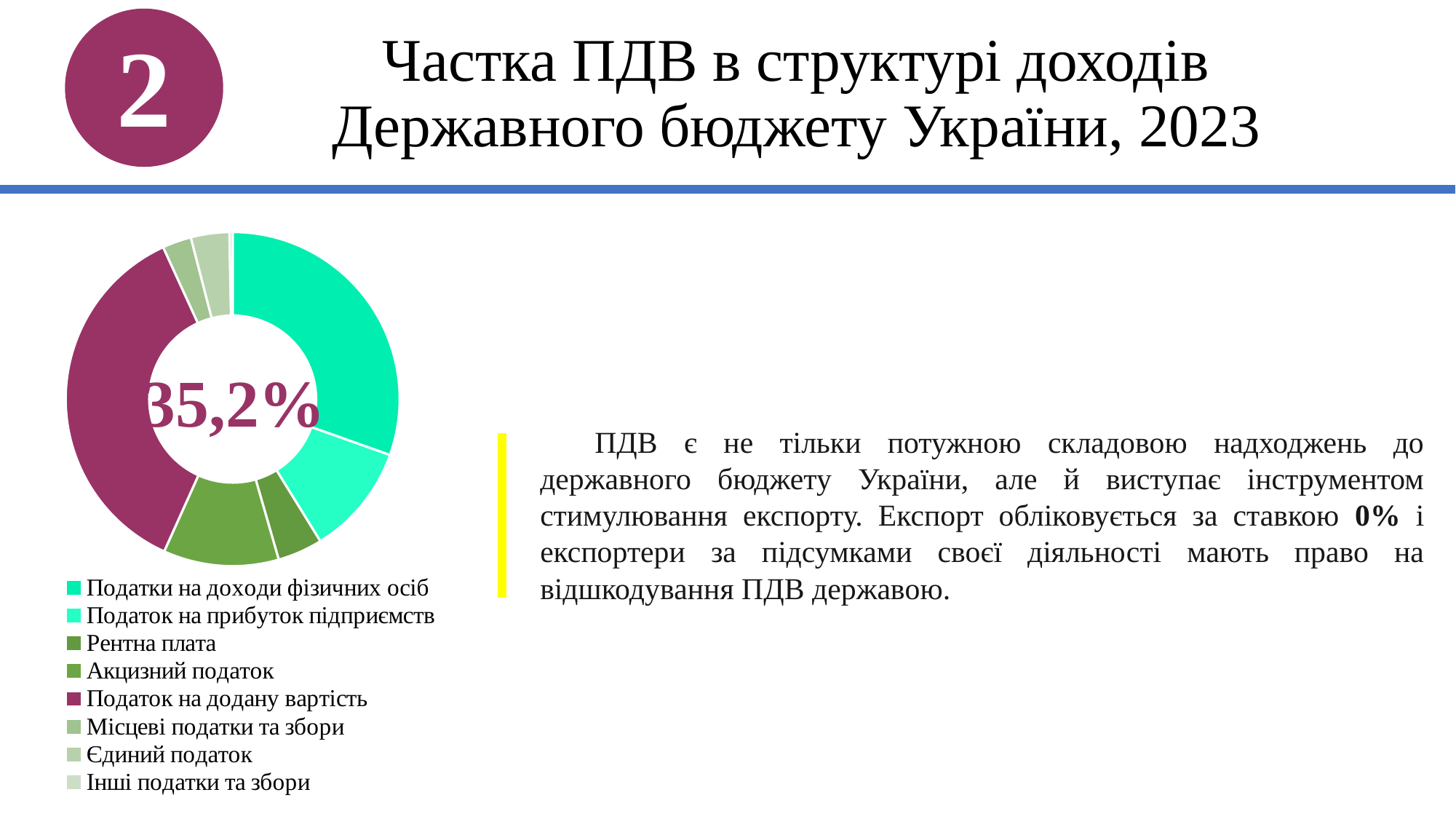
Which legend entry is shown in the dark magenta colour? Податок на додану вартість Which is larger: the slice for Податки на доходи фізичних осіб or the slice for Місцеві податки та збори? Податки на доходи фізичних осіб Which is larger: the slice for Податок на прибуток підприємств or the slice for Єдиний податок? Податок на прибуток підприємств What kind of chart is shown on the slide? Doughnut (pie) chart What share of State budget revenues does VAT (Податок на додану вартість) account for, according to the value printed in the centre of the chart? 35,2% Which is larger: the slice for Акцизний податок or the slice for Інші податки та збори? Акцизний податок How many categories does the chart's legend list? 8 What is the title of the slide containing the chart? Частка ПДВ в структурі доходів Державного бюджету України, 2023